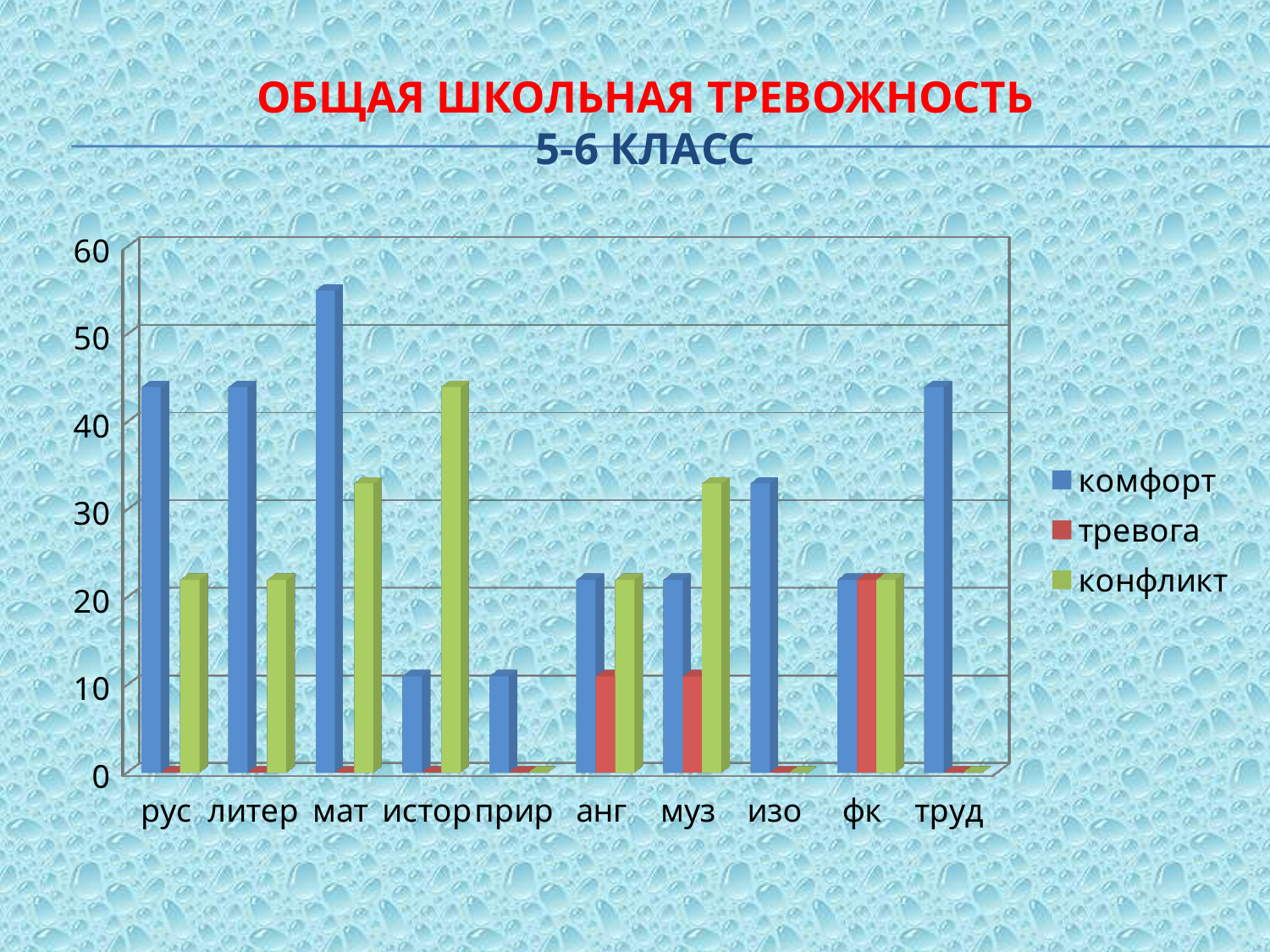
Which is larger: the комфорт value for рус or the комфорт value for прир? рус Is the комфорт value for истор greater or less than 20? less How many subject categories are shown along the x axis? 10 Which series is shown in green in the legend? конфликт Which subject has the highest value for конфликт? истор Which subject has the highest value for комфорт? мат Is the конфликт value for истор greater or less than 30? greater How many series does the legend list? 3 What kind of chart is shown on the slide? bar chart Which is larger: the конфликт value for мат or the конфликт value for литер? мат Is the комфорт value for мат greater or less than 50? greater Which subject has the highest value for тревога? фк